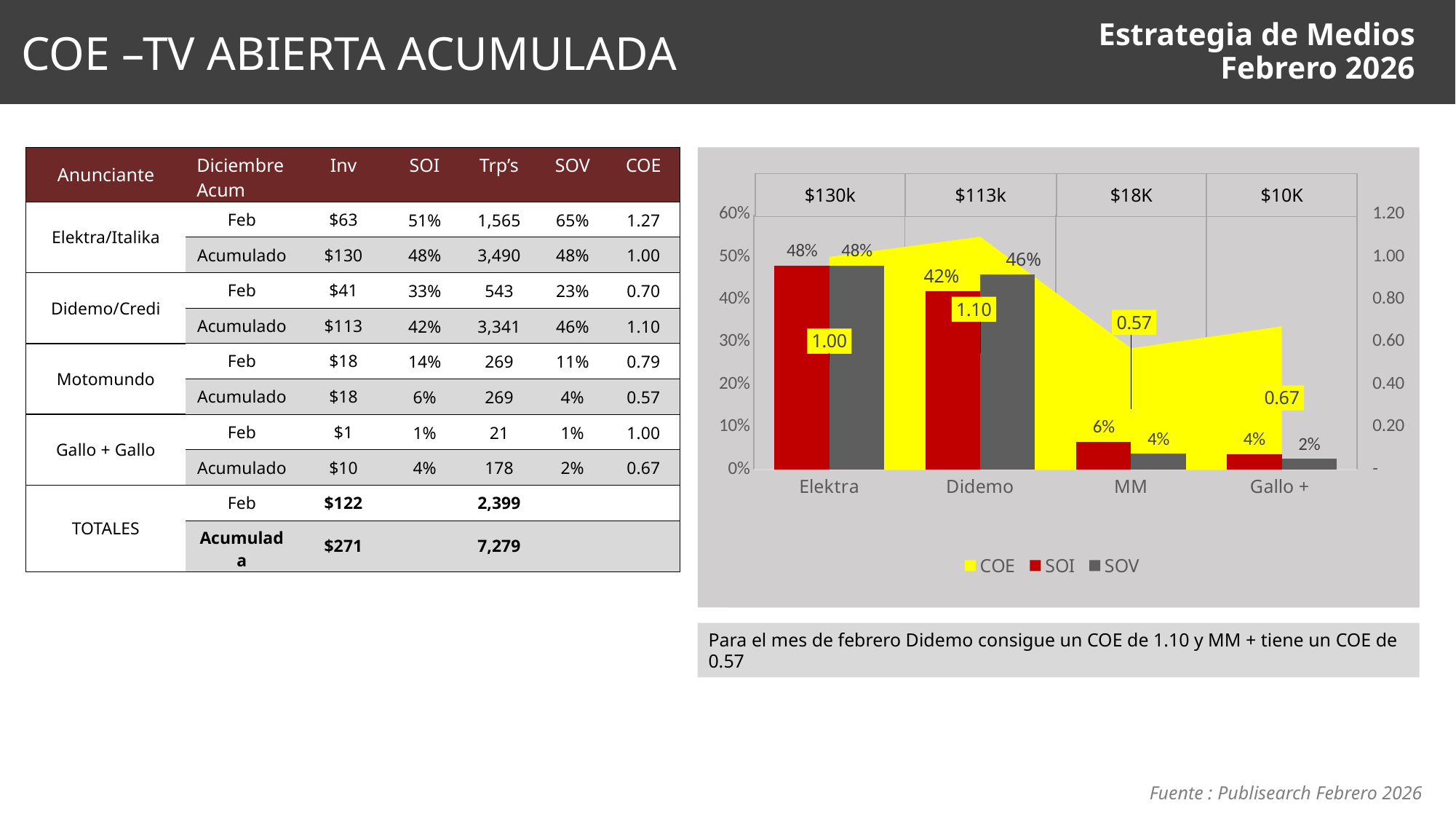
Which category has the lowest SOV value? Gallo + Which is larger, the SOI value for Elektra or the SOI value for Didemo? Elektra What is the difference between the SOV and SOI values for Didemo? 4 percentage points What is the SOV value for Gallo +? 2% What investment figure is shown above the Didemo bars? $113k What is the COE value for MM? 0.57 Which category has the highest COE value? Didemo Does the SOI value rise or fall from Elektra to Gallo + along the x axis? Falls Which series is drawn in yellow? COE How many series does the legend list? 3 How many categories are shown on the x axis? 4 What is the SOI value for Didemo? 42%